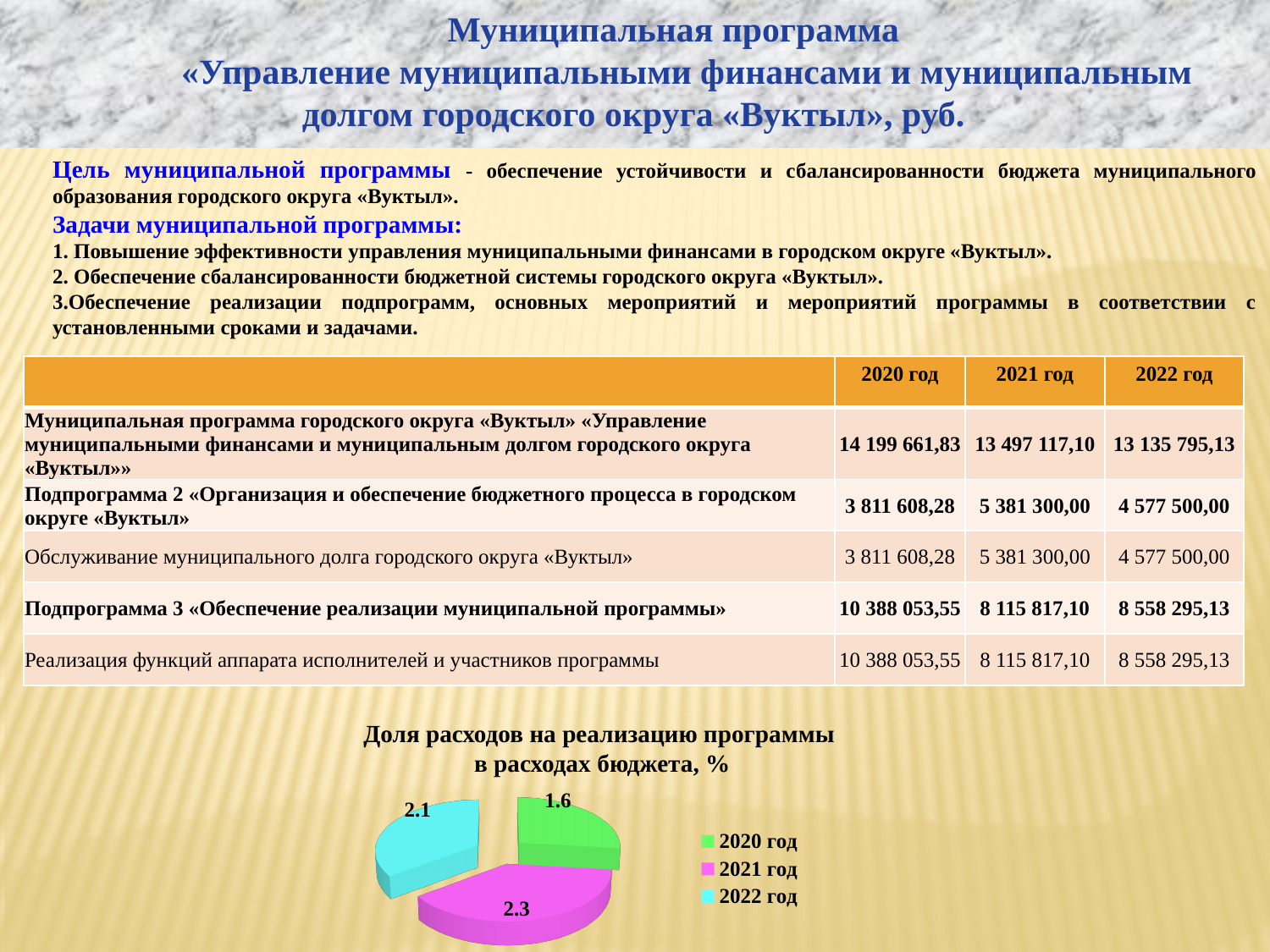
What kind of chart is shown at the bottom of the slide? pie chart Which year has the largest slice in the pie chart? 2021 год What is the title of the pie chart? Доля расходов на реализацию программы в расходах бюджета, % What value is shown for 2021 год in the pie chart? 2.3 What is the difference between the values for 2021 год and 2020 год in the pie chart? 0.7 In the pie chart, which is larger: the value for 2022 год or the value for 2020 год? 2022 год What colour is the slice for 2021 год in the pie chart? magenta (pink) What is the difference between the values for 2022 год and 2020 год in the pie chart? 0.5 Which year has the smallest slice in the pie chart? 2020 год How many slices does the pie chart have? 3 What value is shown for 2022 год in the pie chart? 2.1 What value is shown for 2020 год in the pie chart? 1.6